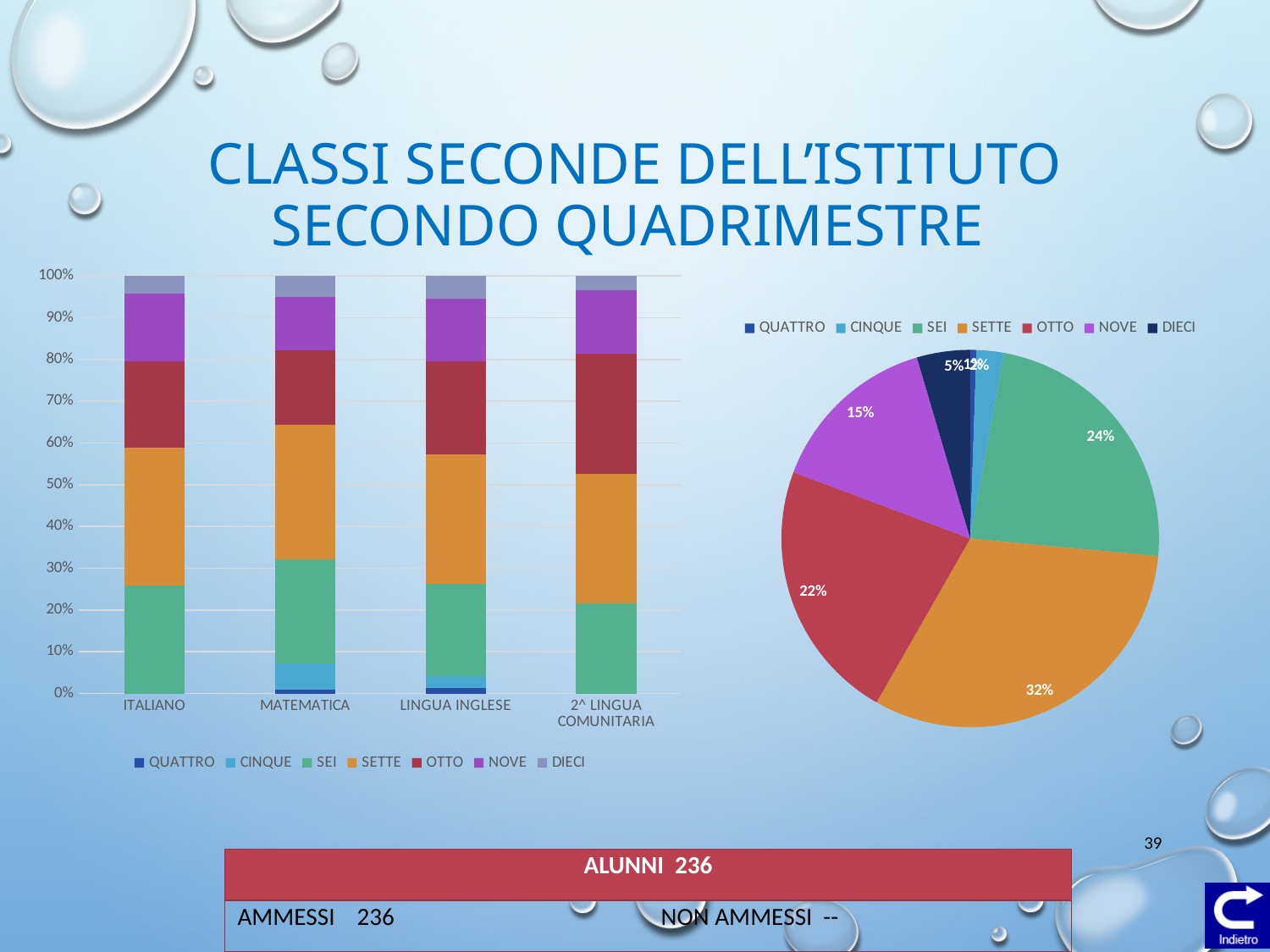
In the pie chart, what share does OTTO have? 22% In the pie chart, what share does DIECI have? 5% In the pie chart, what share does SEI have? 24% In the bar chart on the left, which subject has the largest CINQUE segment? MATEMATICA In the pie chart, by how many percentage points does SETTE exceed SEI? 8 percentage points How many series does the legend of the bar chart on the left list? 7 In the pie chart, which slice is larger, OTTO or NOVE? OTTO How many subject categories are shown on the x axis of the bar chart on the left? 4 What kind of chart is the chart on the left of the slide? Stacked bar chart In the pie chart, which grade has the largest slice? SETTE